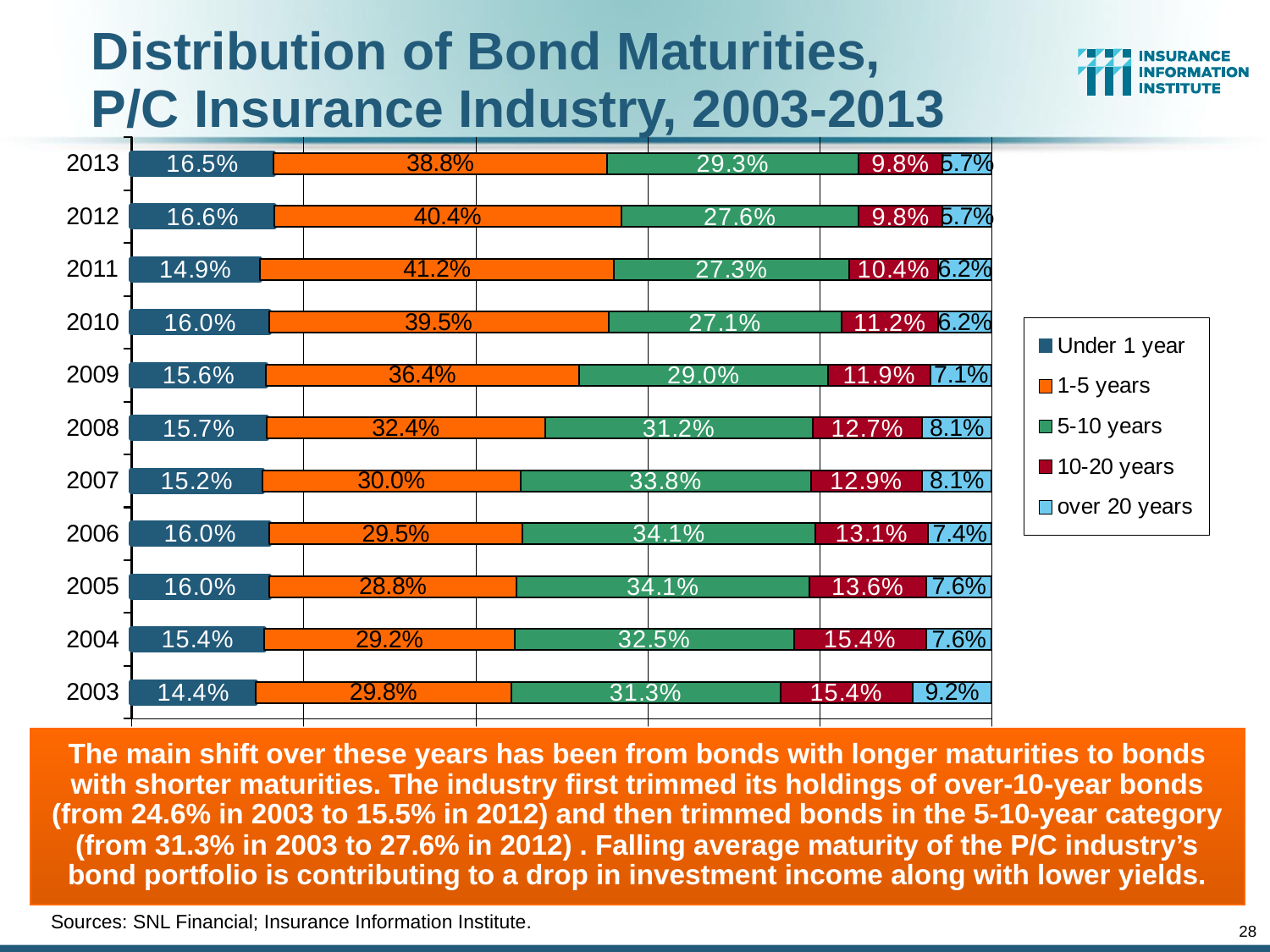
What share of bonds had maturities of 1-5 years in 2011? 41.2% What kind of chart is shown on the slide? Stacked bar chart In which year was the over 20 years share the highest? 2003 In which year was the 1-5 years share the highest? 2011 What was the 5-10 years share in 2003? 31.3% How many years are shown on the chart? 11 What was the combined share of 10-20 years and over 20 years bonds in 2003? 24.6% Which year had a larger 5-10 years share, 2007 or 2013? 2007 By how many percentage points did the 10-20 years share fall from 2003 to 2013? 5.6 percentage points Overall, did the 1-5 years share rise or fall from 2003 to 2013? Rise How many series does the legend list? 5 What was the Under 1 year share in 2009? 15.6%